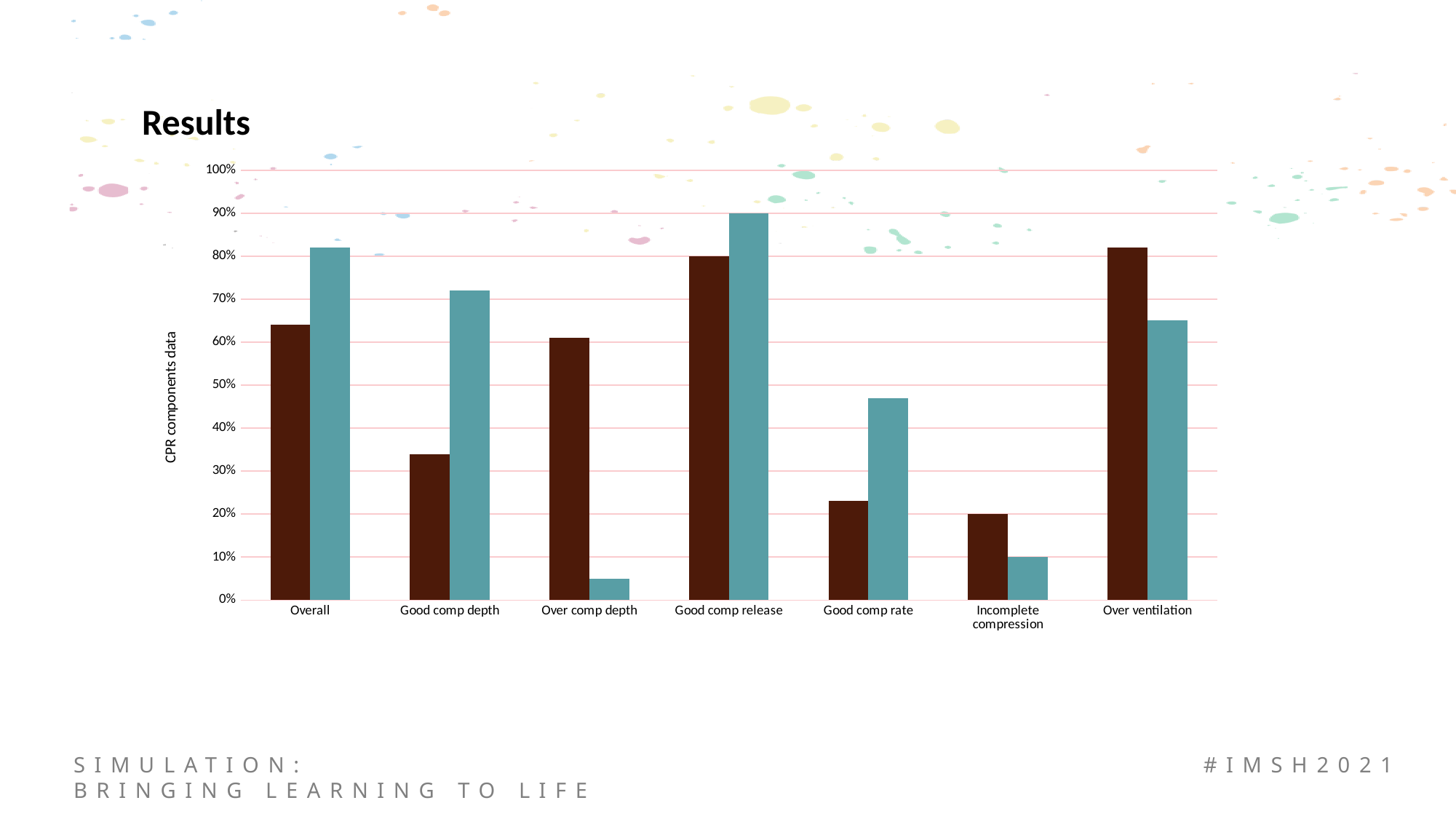
What kind of chart is shown on the slide? bar chart What is the difference between the dark brown bar and the teal bar for Incomplete compression? 10% How many categories are shown along the x axis of the chart? 7 What is the value of the teal bar for Good comp release? 90% What is the value of the teal bar for Incomplete compression? 10% What is the value of the dark brown bar for Incomplete compression? 20% Which category has the highest teal bar? Good comp release For Over ventilation, which bar is taller, the dark brown bar or the teal bar? the dark brown bar Is the value of the teal bar for Over comp depth greater or less than 10%? less What is the value of the dark brown bar for Good comp release? 80% Which category has the lowest teal bar? Over comp depth Is the value of the dark brown bar for Overall greater or less than 60%? greater